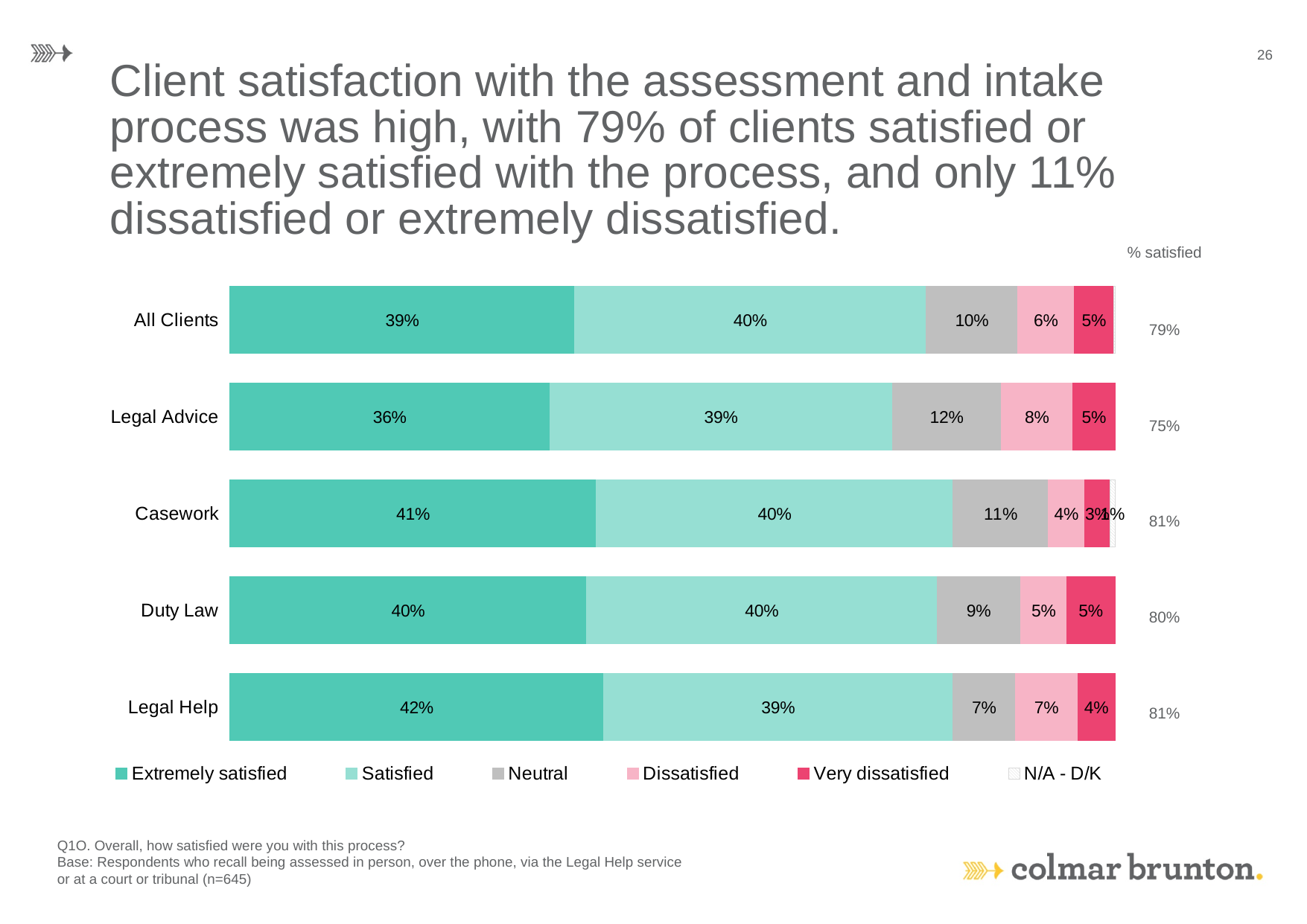
How many categories are shown on the chart? 5 Which category has the lowest % satisfied figure? Legal Advice Which category has the highest Extremely satisfied value? Legal Help What percentage of All Clients were Extremely satisfied? 39% What kind of chart is shown on the slide? Stacked bar chart How many series does the legend list? 6 What is the last entry in the chart legend? N/A - D/K Is the Neutral value larger for Legal Advice or for Legal Help? Legal Advice What is the % satisfied figure shown for Casework? 81% What is the difference between the Extremely satisfied values for Legal Help and Legal Advice? 6% What is the Neutral value for Legal Advice? 12% What is the Very dissatisfied value for Legal Help? 4%